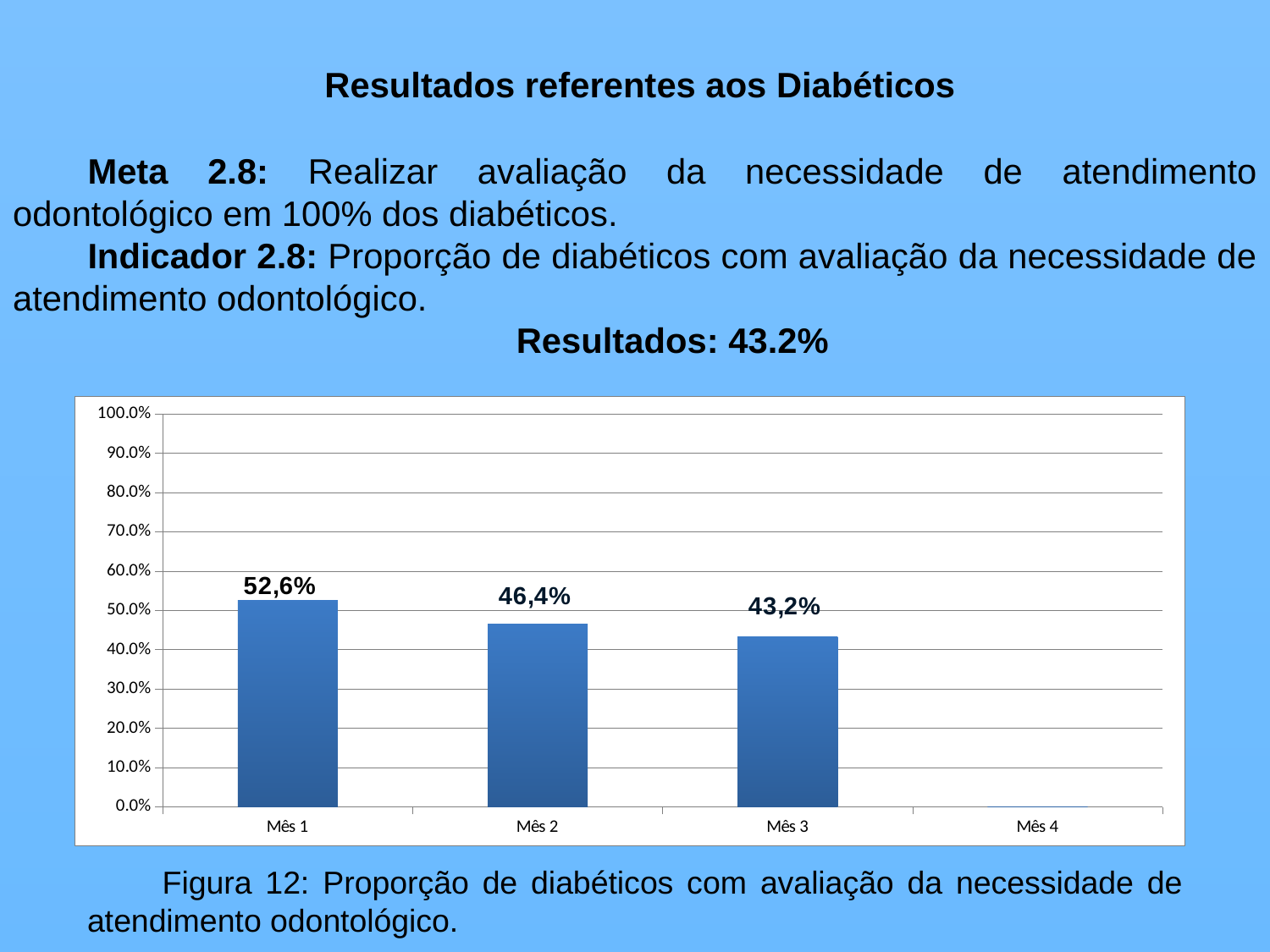
What is the value for Mês 3? 43,2% Among the months with a plotted bar, which has the lowest value? Mês 3 What is the value for Mês 2? 46,4% What is the difference between the values for Mês 1 and Mês 2? 6,2% Which is larger, the value for Mês 2 or the value for Mês 3? Mês 2 What is the value for Mês 1? 52,6% What kind of chart is shown on the slide? bar chart Do the values rise or fall from Mês 1 to Mês 3? fall What is the difference between the values for Mês 1 and Mês 3? 9,4% Is the value for Mês 1 greater or less than 50.0%? greater How many categories are shown on the x axis? 4 Which month has the highest value? Mês 1